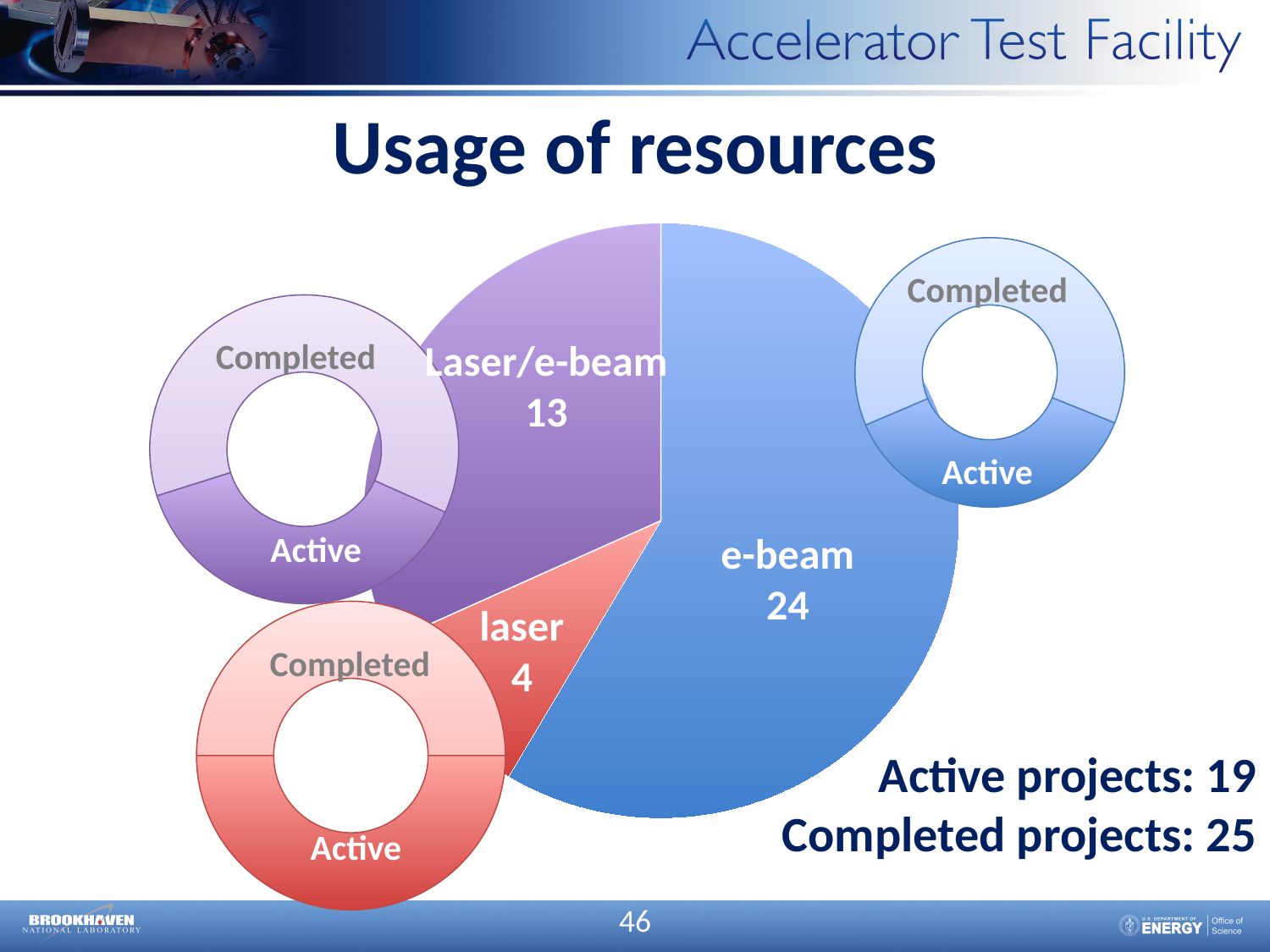
In the purple donut chart on the left, which segment is larger, Completed or Active? Completed How many slices does the main pie chart have? 3 In the main pie chart, what is the value for laser? 4 What kind of chart is the large central chart on the slide? pie chart In the main pie chart, which is larger, Laser/e-beam or laser? Laser/e-beam In the main pie chart, which category has the largest value? e-beam In the main pie chart, what is the difference between the e-beam value and the laser value? 20 In the main pie chart, what is the difference between the e-beam value and the Laser/e-beam value? 11 In the main pie chart, what is the value for Laser/e-beam? 13 In the main pie chart, what is the value for e-beam? 24 What is the total of the three values shown in the main pie chart? 41 In the main pie chart, which category has the smallest value? laser